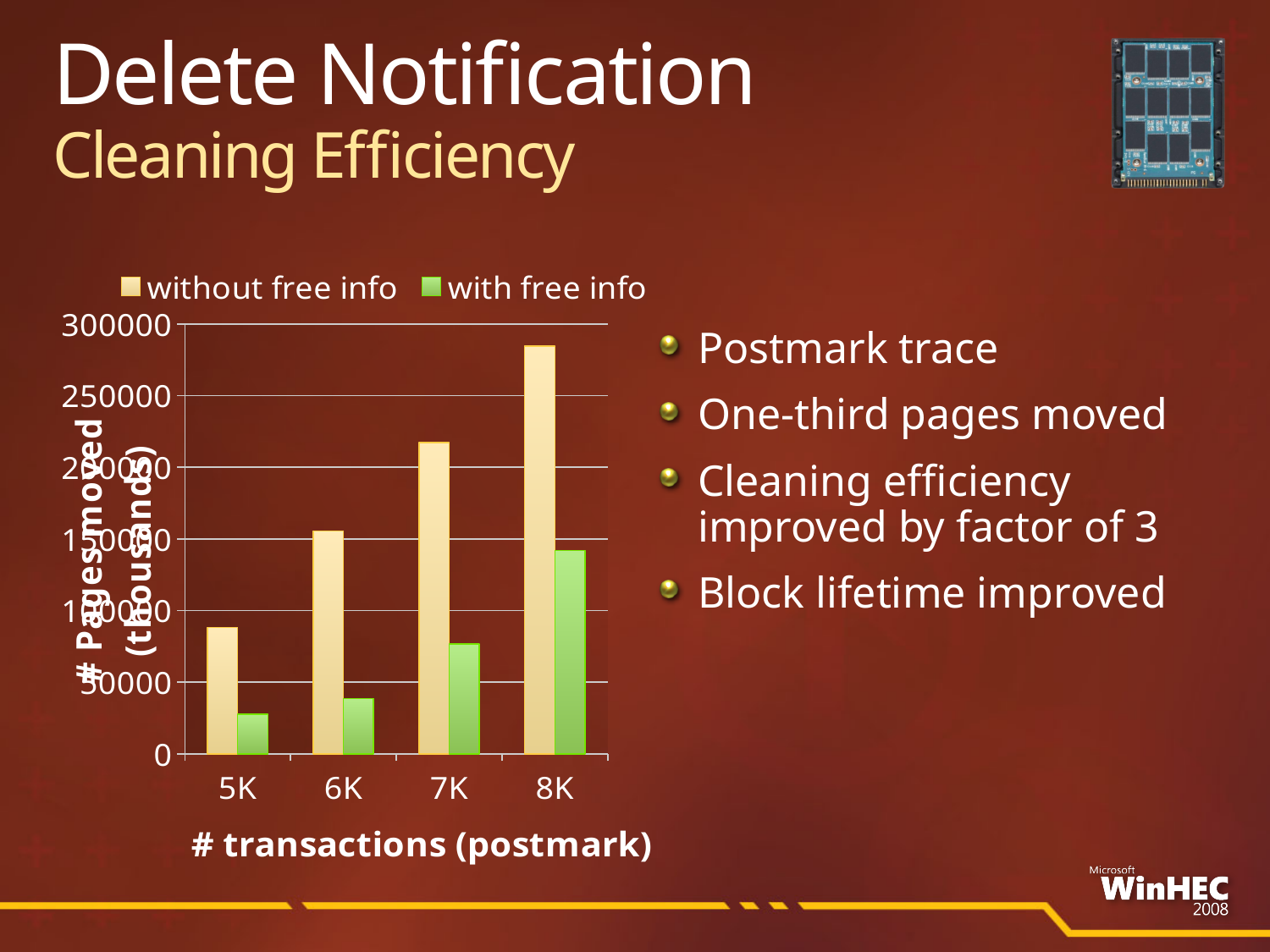
Is the 'with free info' value at 8K greater or less than 100000? greater Is the 'without free info' value at 8K greater or less than 250000? greater Which transaction count has the lowest value for 'with free info'? 5K Is the 'with free info' value at 5K greater or less than 50000? less At 8K transactions, which series has the larger value, 'without free info' or 'with free info'? without free info Which transaction count has the highest value for 'without free info'? 8K What is the label of the x axis of the chart? # transactions (postmark) How many series does the chart legend list? 2 What kind of chart is shown on the slide? bar chart Do the 'with free info' values rise or fall as the number of transactions increases from 5K to 8K? rise How many transaction categories are shown on the x axis? 4